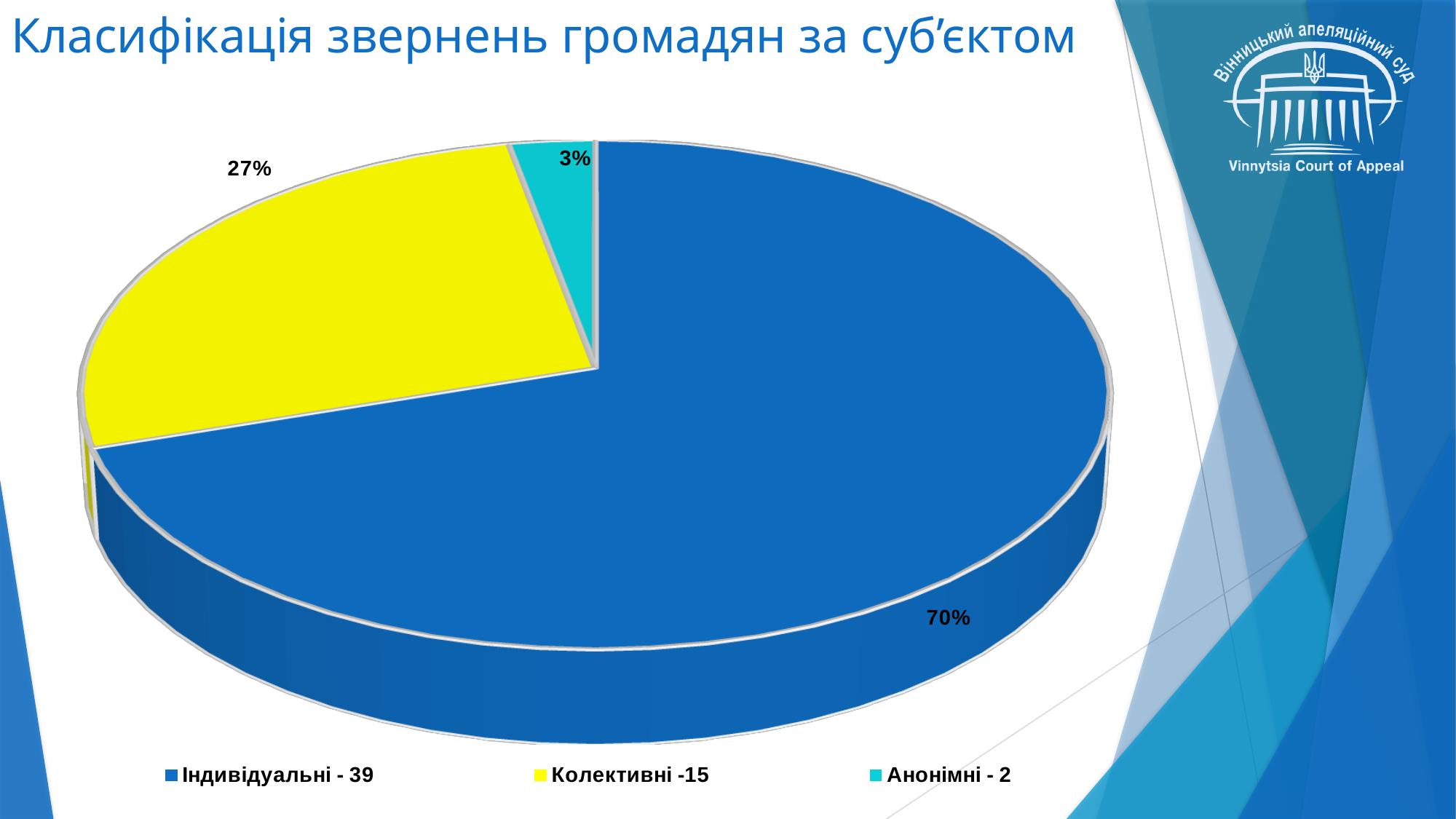
What colour is the Колективні slice in the pie chart? yellow What percentage share does the Анонімні slice have? 3% What percentage share does the Індивідуальні slice have? 70% Which slice is larger, Колективні or Анонімні? Колективні What is the difference in percentage points between the Індивідуальні and Колективні slices? 43% What is the title of the slide containing the chart? Класифікація звернень громадян за суб'єктом How many entries does the legend list? 3 Which category has the smallest slice of the pie? Анонімні What percentage share does the Колективні slice have? 27% Which category has the largest slice of the pie? Індивідуальні How many categories does the pie chart show? 3 What kind of chart is shown on the slide? pie chart